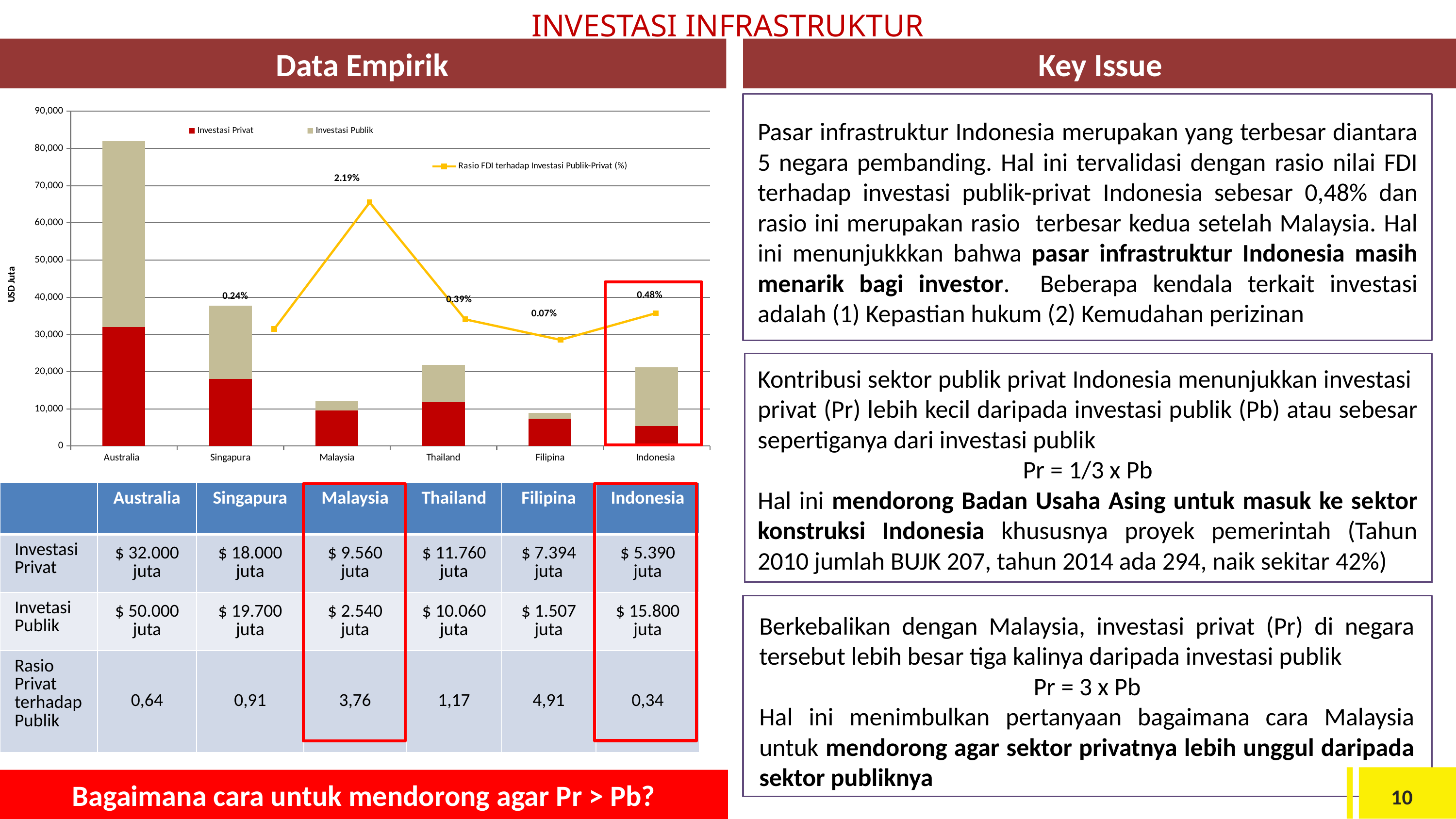
How many series does the chart legend list? 3 How many countries are shown on the x axis of the chart? 6 Which has a larger Rasio FDI terhadap Investasi Publik-Privat, Thailand or Singapura? Thailand What is the Rasio FDI terhadap Investasi Publik-Privat value for Filipina? 0.07% Which country has the lowest Rasio FDI terhadap Investasi Publik-Privat? Filipina Is the Investasi Privat value for Indonesia greater or less than 10,000? less What is the Rasio FDI terhadap Investasi Publik-Privat value for Malaysia? 2.19% Which country has the highest Rasio FDI terhadap Investasi Publik-Privat? Malaysia What is the Rasio FDI terhadap Investasi Publik-Privat value for Indonesia? 0.48% What is the difference between the Rasio FDI values for Malaysia and Indonesia? 1.71% What kind of chart is shown on the slide? stacked bar chart with a line Which country has the tallest stacked bar in the chart? Australia